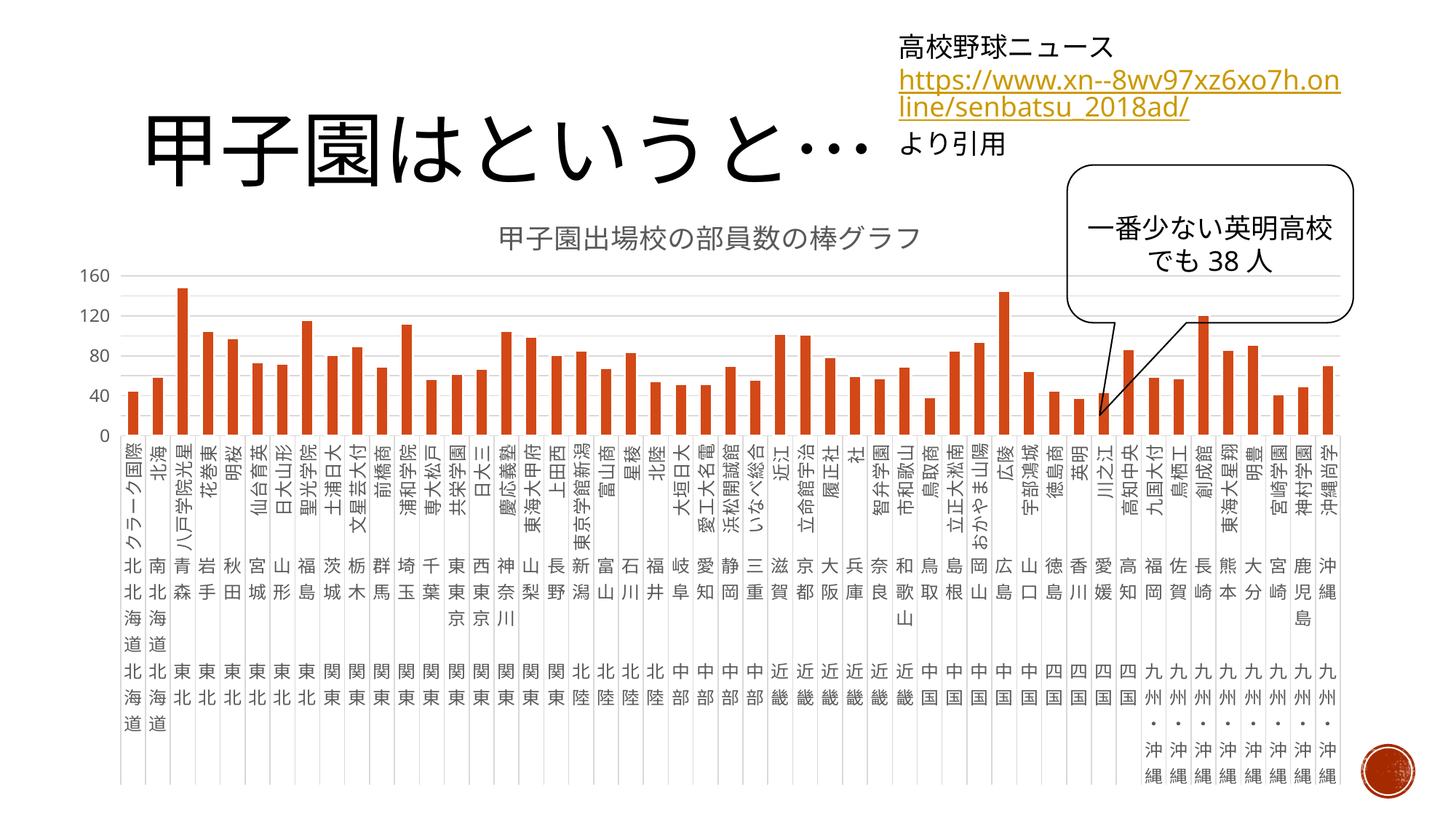
Is the value for 北陸 greater or less than 80? less Is the value for 広陵 greater or less than 120? greater Is the value for 創成館 greater or less than 80? greater Which has more club members, 広陵 or 宇部鴻城? 広陵 What kind of chart is shown on the slide? bar chart What is the title of the chart? 甲子園出場校の部員数の棒グラフ Which school has the lowest number of club members in the chart? 英明 Which has more club members, 慶応義塾 or 北陸? 慶応義塾 How many club members does 英明 have, according to the callout on the slide? 38人 What colour are the bars in the chart? orange